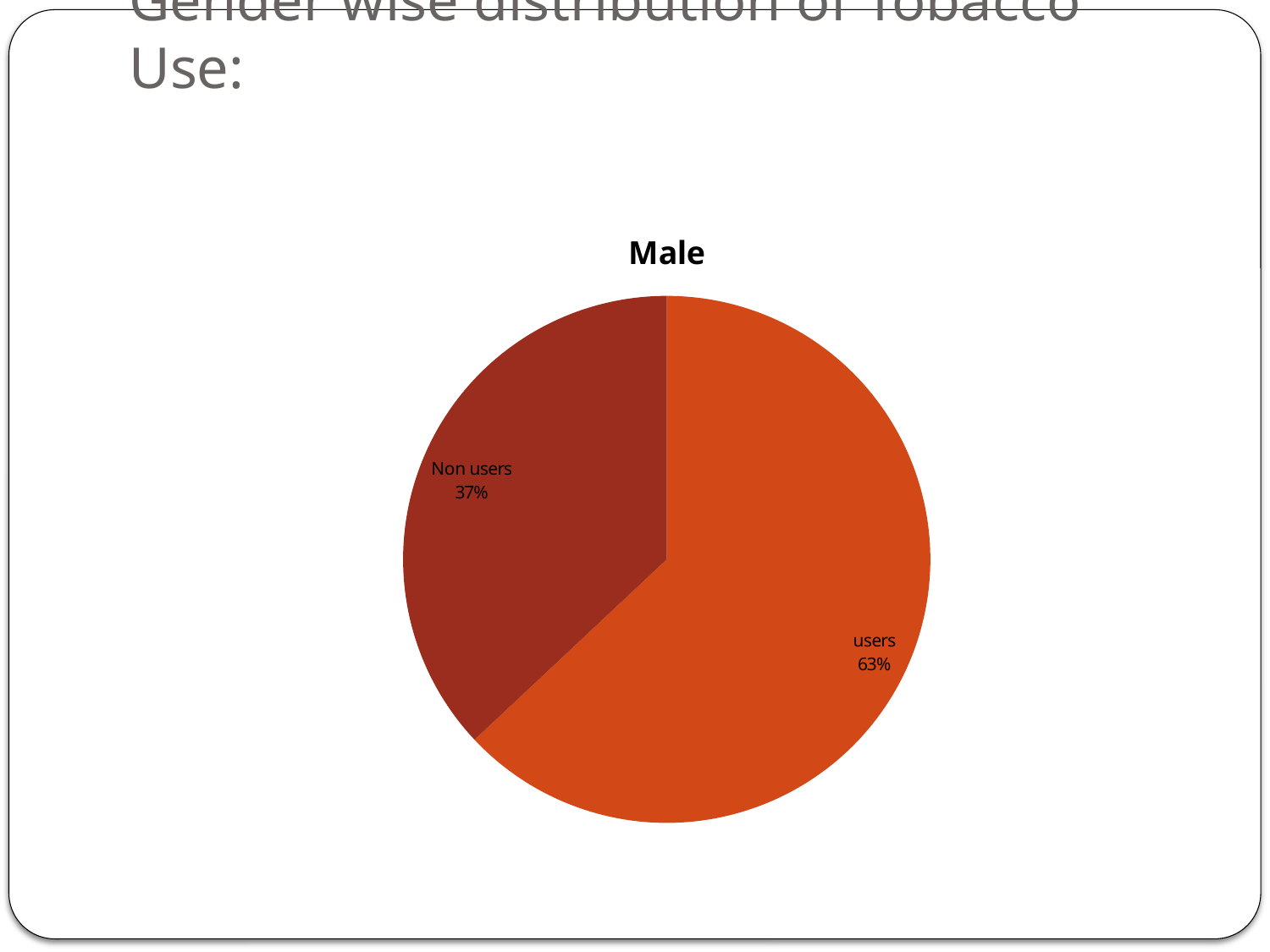
What is the difference in percentage points between the 'users' and 'Non users' slices? 26 What is the title of the chart? Male Which is larger, the 'users' slice or the 'Non users' slice? users Is the share for 'Non users' greater or less than 50%? less What kind of chart is shown on the slide? pie chart What share of the pie is labelled 'users'? 63% Which slice of the pie is the largest? users What is the total of the two slices shown in the pie chart? 100% What share of the pie is labelled 'Non users'? 37% Which slice is shown in the darker red colour? Non users How many slices does the pie chart have? 2 Which slice of the pie is the smallest? Non users